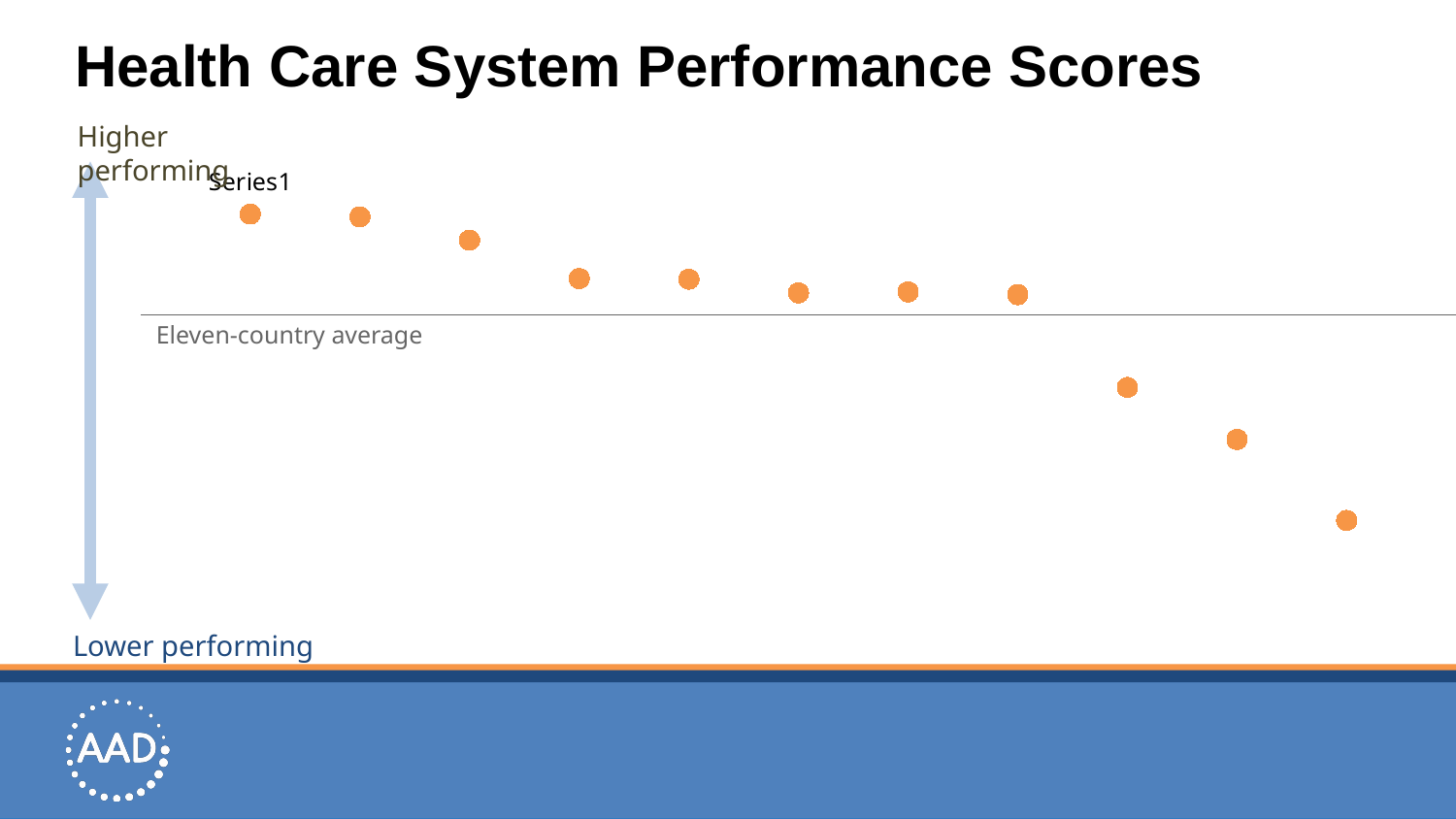
What is the name of the series shown in the legend? Series1 How many data points lie above the eleven-country average line? 8 How many data points lie below the eleven-country average line? 3 How many data points are plotted on the chart? 11 What is the title of the chart on the slide? Health Care System Performance Scores Which is higher on the chart, the leftmost data point or the rightmost data point? The leftmost data point How many series does the chart's legend list? 1 Is the rightmost data point above or below the eleven-country average line? Below Is the leftmost data point above or below the eleven-country average line? Above Do the plotted values rise or fall from left to right along the x axis? Fall What kind of chart is shown on the slide? Scatter (dot) chart